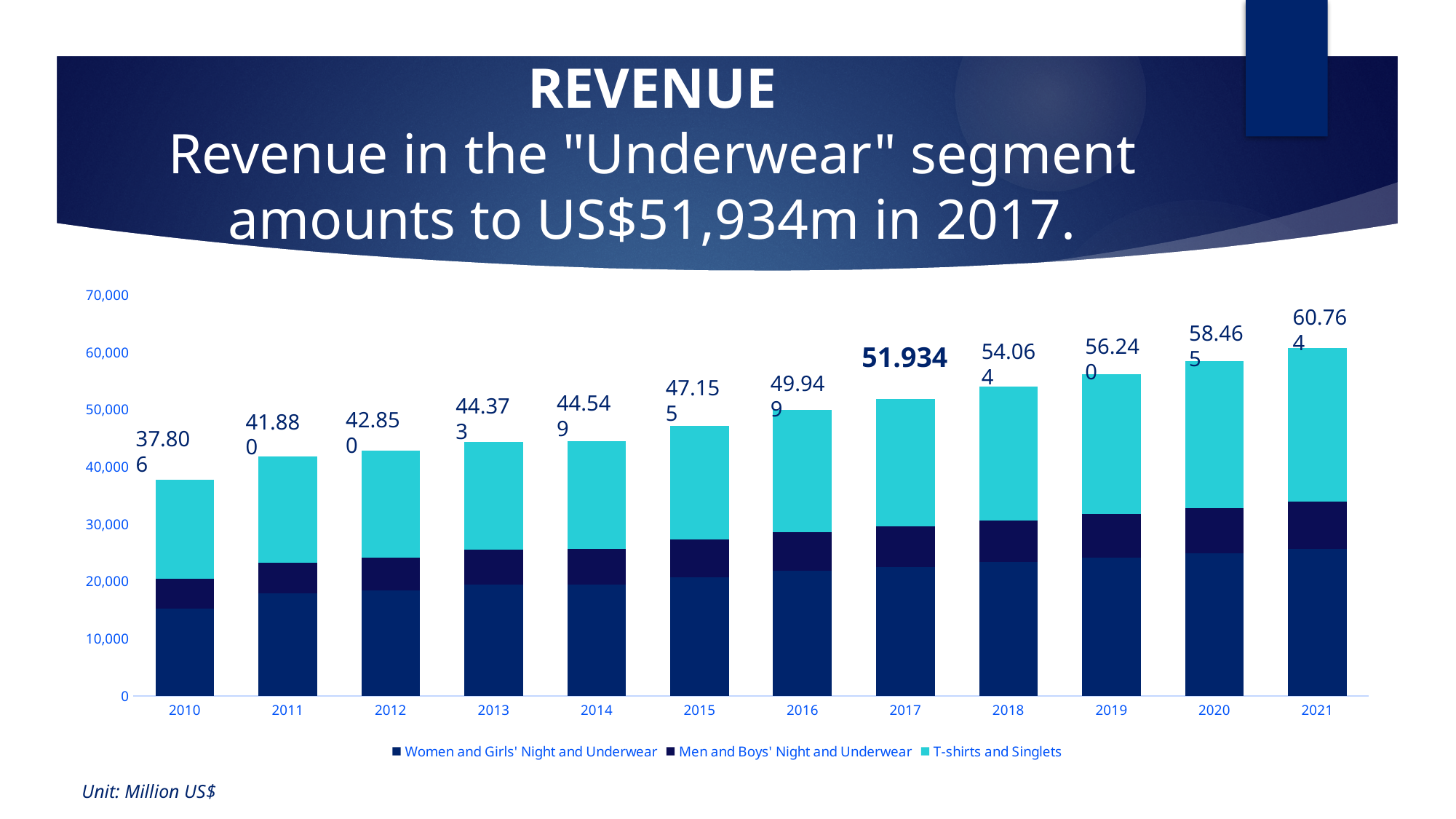
Does total revenue rise or fall from 2010 to 2021? Rises What type of chart is shown on the slide? Stacked bar chart Which is larger, the total revenue for 2015 or for 2016? 2016 What is the total revenue label shown for 2010? 37.806 How many years are shown on the x axis? 12 Which year has the lowest total revenue? 2010 How many series does the legend list? 3 What is the total revenue label shown for 2017? 51.934 What is the total revenue label shown for 2021? 60.764 Is the value of the Women and Girls' Night and Underwear segment in 2010 greater or less than 20,000? less What unit is stated for the values in the chart? Million US$ Which year has the highest total revenue? 2021